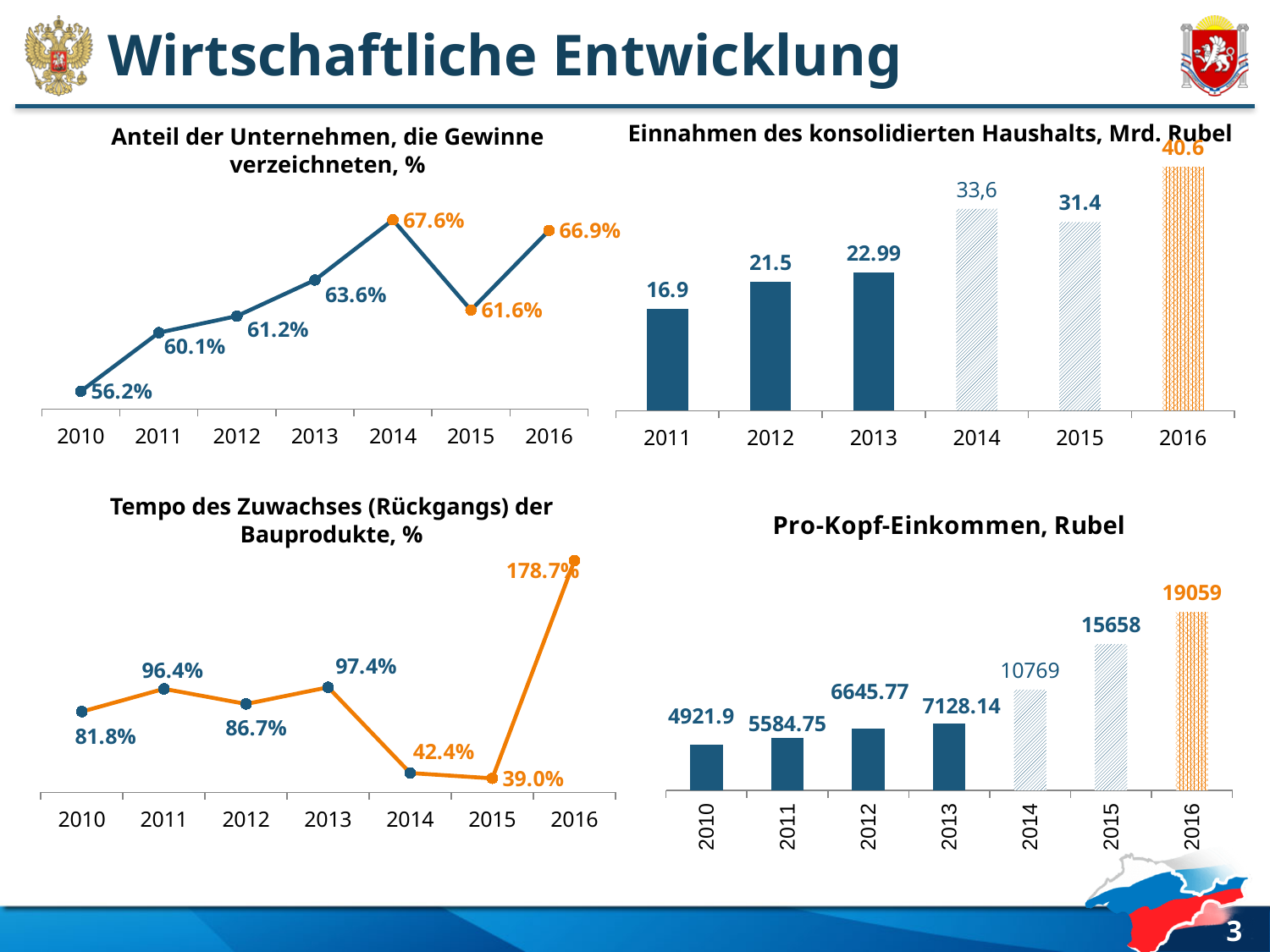
In the chart 'Anteil der Unternehmen, die Gewinne verzeichneten, %', which year has the lowest value? 2010 In the chart 'Anteil der Unternehmen, die Gewinne verzeichneten, %', what is the difference between the 2014 and 2010 values? 11.4 percentage points In the chart 'Einnahmen des konsolidierten Haushalts, Mrd. Rubel', how many years are shown? 6 In the chart 'Einnahmen des konsolidierten Haushalts, Mrd. Rubel', which year has the highest value? 2016 In the chart 'Einnahmen des konsolidierten Haushalts, Mrd. Rubel', what is the value for 2013? 22.99 In the chart 'Tempo des Zuwachses (Rückgangs) der Bauprodukte, %', which is larger, the value for 2011 or the value for 2013? 2013 In the chart 'Anteil der Unternehmen, die Gewinne verzeichneten, %', what is the value for 2014? 67.6% In the chart 'Einnahmen des konsolidierten Haushalts, Mrd. Rubel', how much higher is the 2016 value than the 2011 value? 23.7 In the chart 'Pro-Kopf-Einkommen, Rubel', what is the difference between the 2016 and 2015 values? 3401 In the chart 'Tempo des Zuwachses (Rückgangs) der Bauprodukte, %', what is the value for 2015? 39.0% In the chart 'Pro-Kopf-Einkommen, Rubel', what is the value for 2012? 6645.77 In the chart 'Tempo des Zuwachses (Rückgangs) der Bauprodukte, %', which year has the highest value? 2016